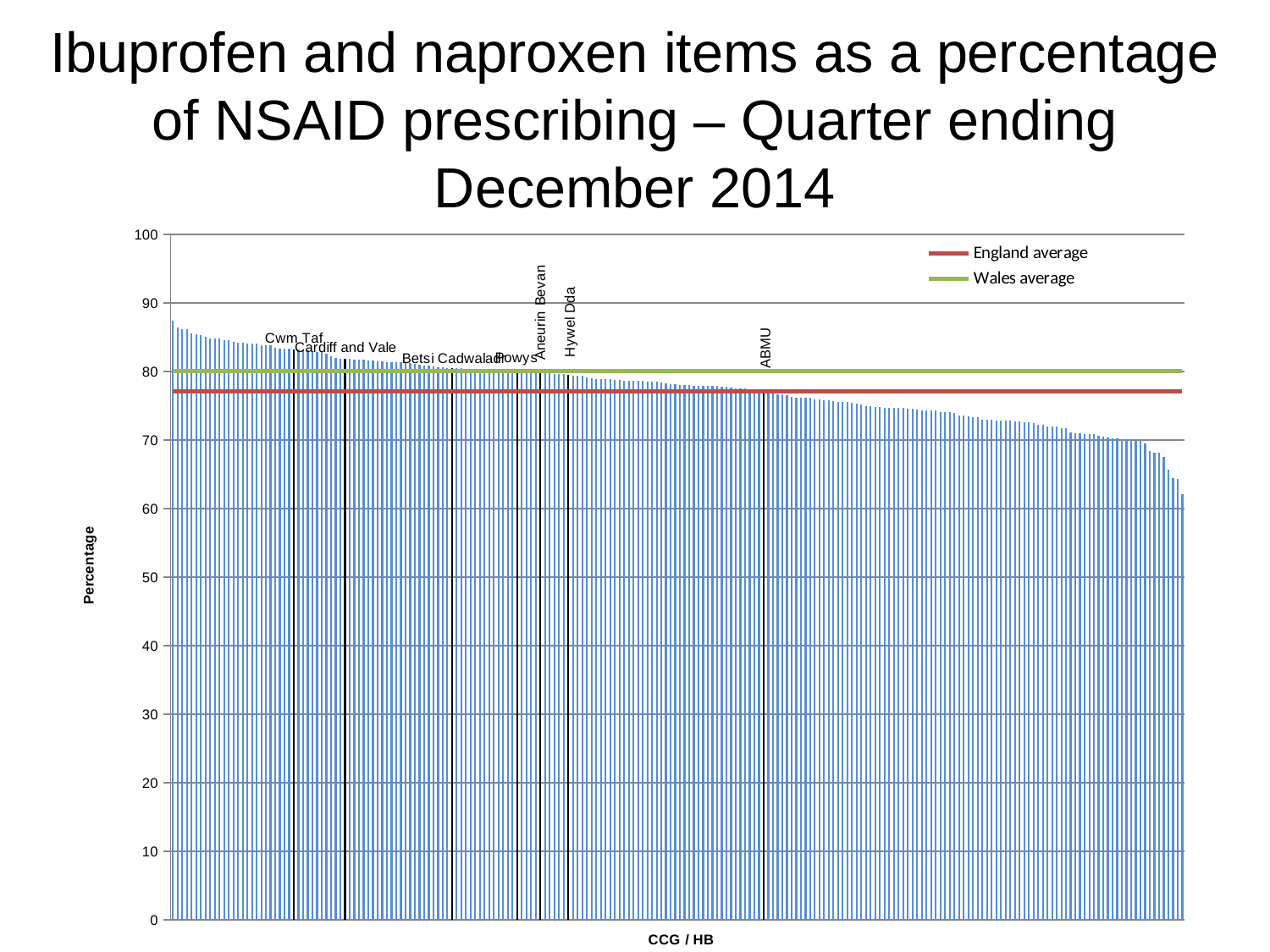
Is the Wales average line greater or less than 70? greater Which is higher, the Wales average line or the England average line? Wales average Is the lowest bar on the chart greater or less than 70? less Which two averages are shown as horizontal lines on the chart? England average and Wales average How many entries does the chart legend list? 2 Which has the higher value, Cwm Taf or ABMU? Cwm Taf Is the value for ABMU greater or less than 80? less What kind of chart is shown on the slide? Bar chart Do the bar values rise or fall from left to right along the x axis? Fall What is the label of the vertical axis? Percentage